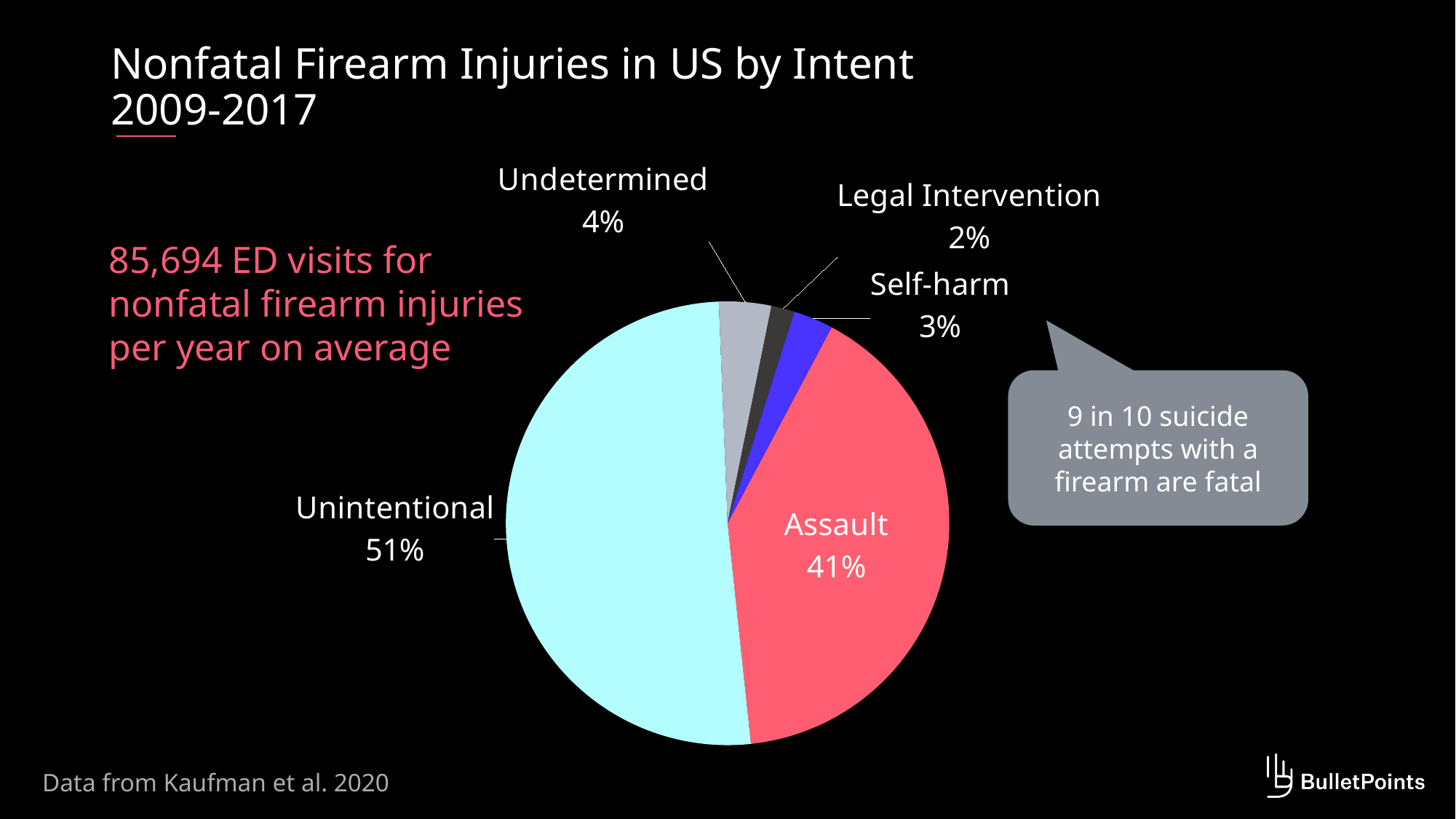
What share of nonfatal firearm injuries is attributed to Undetermined? 4% What share of nonfatal firearm injuries is attributed to Unintentional? 51% What share of nonfatal firearm injuries is attributed to Self-harm? 3% What is the title of the chart on the slide? Nonfatal Firearm Injuries in US by Intent 2009-2017 How many intent categories are shown in the pie chart? 5 What share of nonfatal firearm injuries is attributed to Legal Intervention? 2% What share of nonfatal firearm injuries is attributed to Assault? 41% What kind of chart is shown on the slide? pie chart Which intent category has the smallest share of the pie? Legal Intervention Which slice is larger, Undetermined or Self-harm? Undetermined Which intent category has the largest share of the pie? Unintentional What is the difference in percentage points between the Unintentional and Assault slices? 10